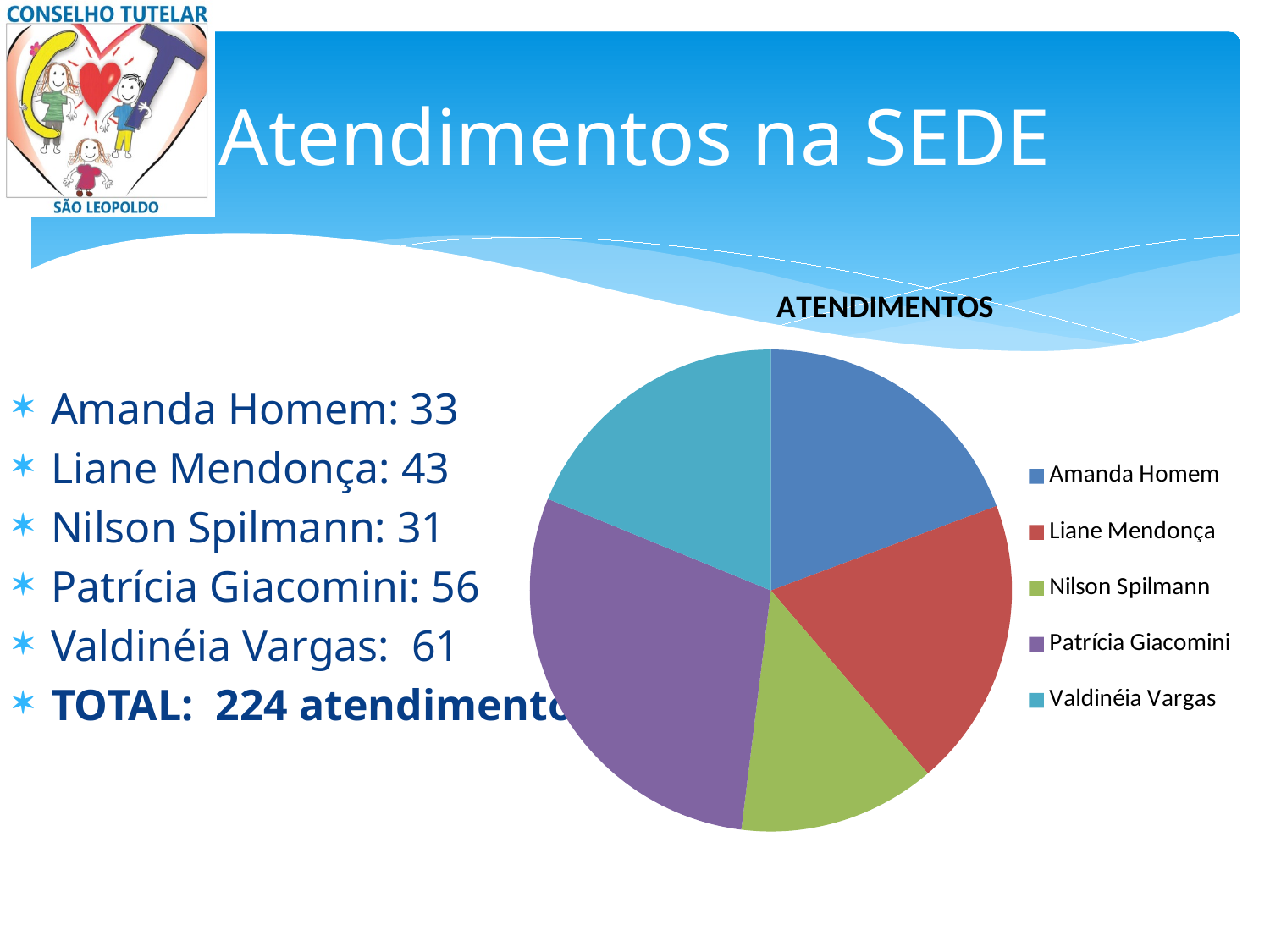
What kind of chart is shown on the slide? pie chart Which category has the largest slice in the pie chart? Patrícia Giacomini Which slice is larger, Patrícia Giacomini or Amanda Homem? Patrícia Giacomini How many entries does the chart legend list? 5 How many slices does the pie chart have? 5 Which colour represents Valdinéia Vargas in the pie chart? teal (light blue) Which slice is larger, Patrícia Giacomini or Nilson Spilmann? Patrícia Giacomini Which category has the smallest slice in the pie chart? Nilson Spilmann What is the title of the chart? ATENDIMENTOS Which slice is larger, Liane Mendonça or Nilson Spilmann? Liane Mendonça